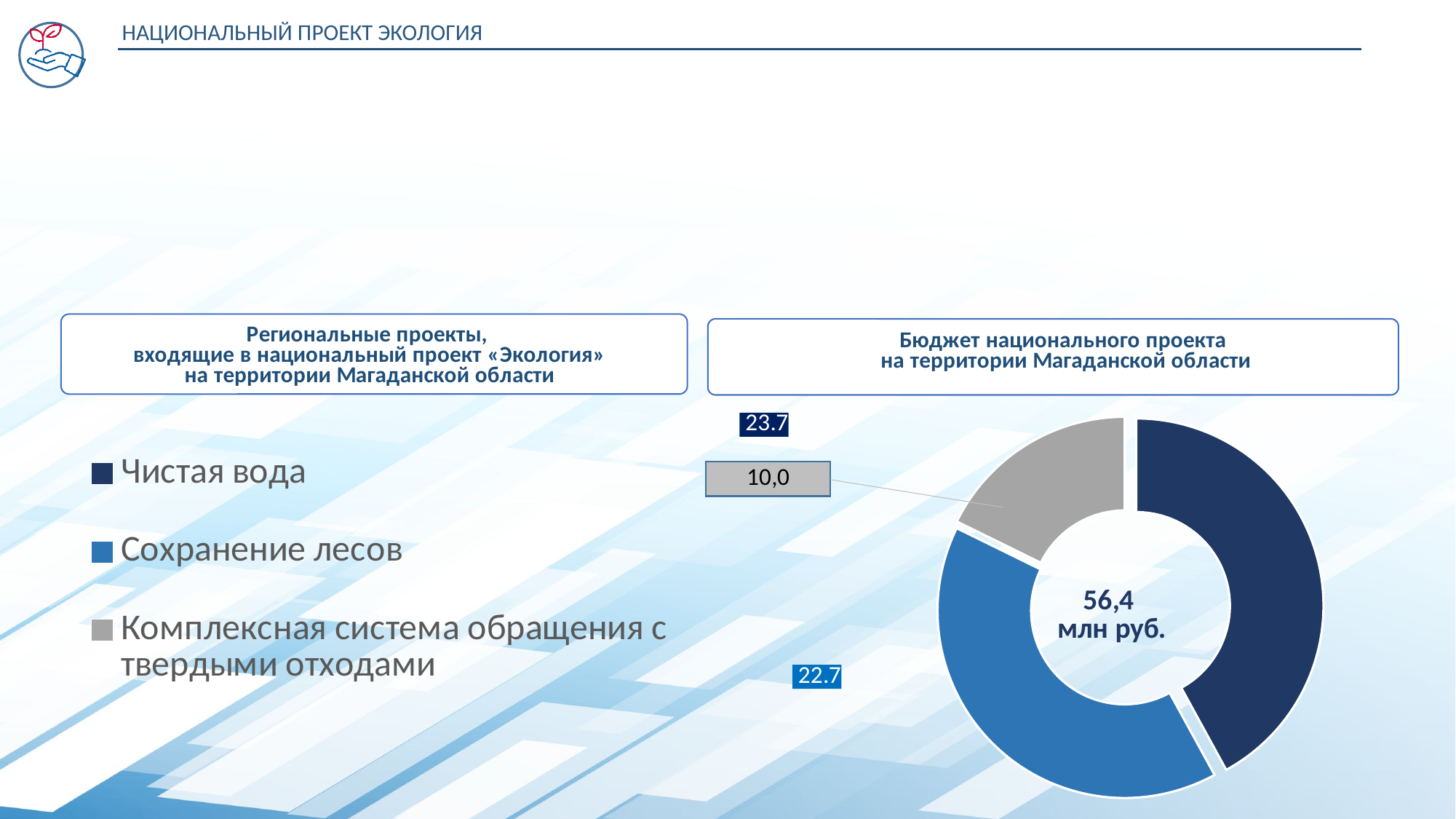
Which category has the largest segment in the donut chart? Чистая вода How many categories are shown in the donut chart? 3 Which category has the smallest segment in the donut chart? Комплексная система обращения с твердыми отходами What is the difference between the values for "Сохранение лесов" and "Комплексная система обращения с твердыми отходами"? 12.7 Which is larger: the value for "Чистая вода" or the value for "Сохранение лесов"? Чистая вода What is the value for "Чистая вода" in the donut chart? 23.7 What type of chart is shown under the title "Бюджет национального проекта на территории Магаданской области"? Pie (donut) chart What total budget is shown in the centre of the donut chart? 56,4 млн руб. What is the value for "Сохранение лесов" in the donut chart? 22.7 What is the difference between the values for "Чистая вода" and "Сохранение лесов"? 1.0 What colour represents "Сохранение лесов" in the legend? Blue What is the value for "Комплексная система обращения с твердыми отходами" in the donut chart? 10,0